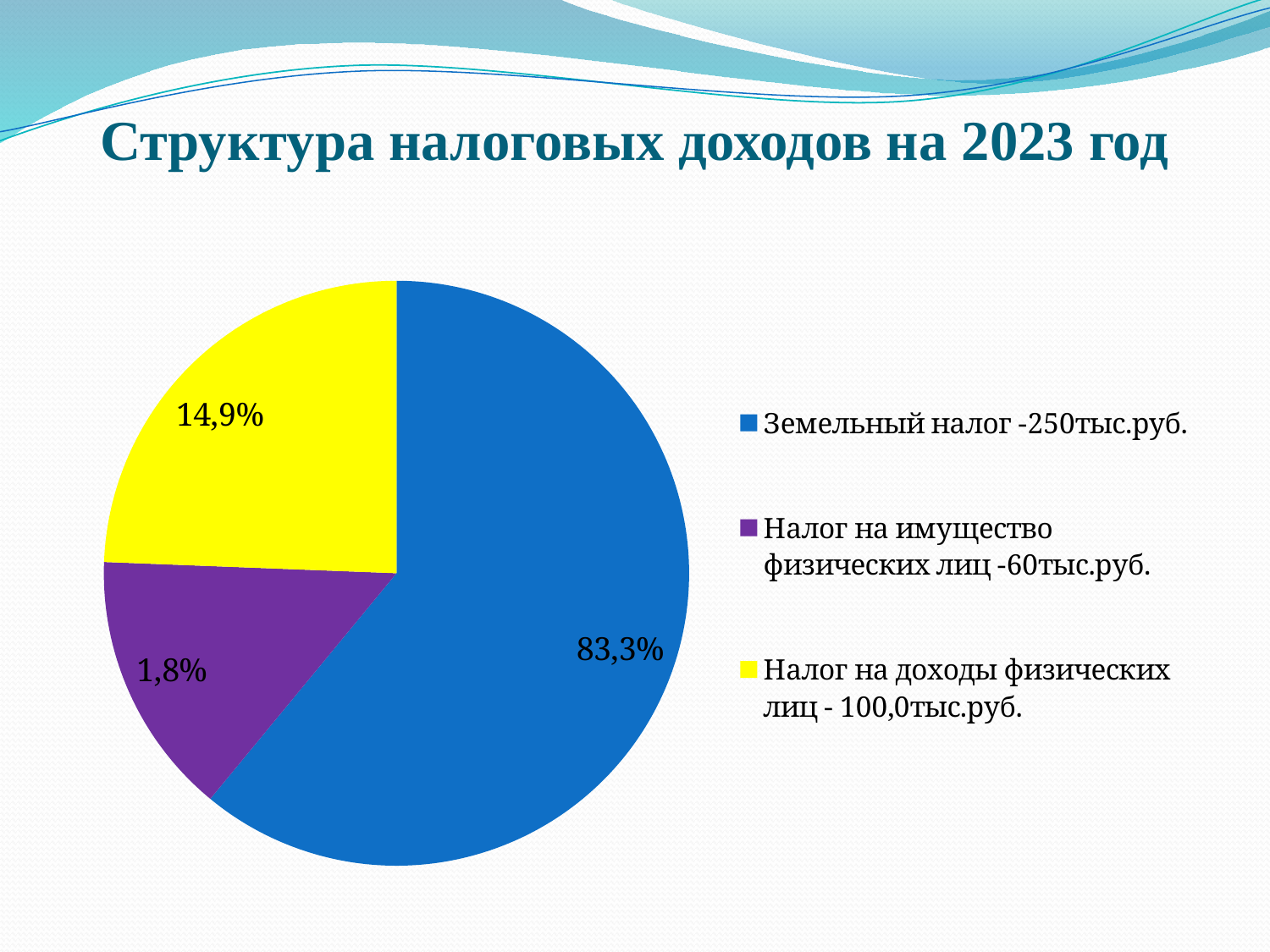
What colour is the slice for "Налог на доходы физических лиц - 100,0тыс.руб."? Yellow Which category has the smallest labelled share of the pie? Налог на имущество физических лиц -60тыс.руб. How many slices does the pie chart have? 3 What type of chart is shown on the slide? Pie chart What percentage is shown for the slice labelled "Налог на доходы физических лиц - 100,0тыс.руб."? 14,9% What is the title of the chart on the slide? Структура налоговых доходов на 2023 год What percentage is shown for the slice labelled "Земельный налог -250тыс.руб."? 83,3% What percentage is shown for the slice labelled "Налог на имущество физических лиц -60тыс.руб."? 1,8% What is the difference between the labelled shares of "Земельный налог" and "Налог на доходы физических лиц"? 68,4% Which has a larger labelled share: "Налог на доходы физических лиц" or "Налог на имущество физических лиц"? Налог на доходы физических лиц Which category has the largest share of the pie? Земельный налог -250тыс.руб. Is the share for "Земельный налог" greater or less than 50%? greater